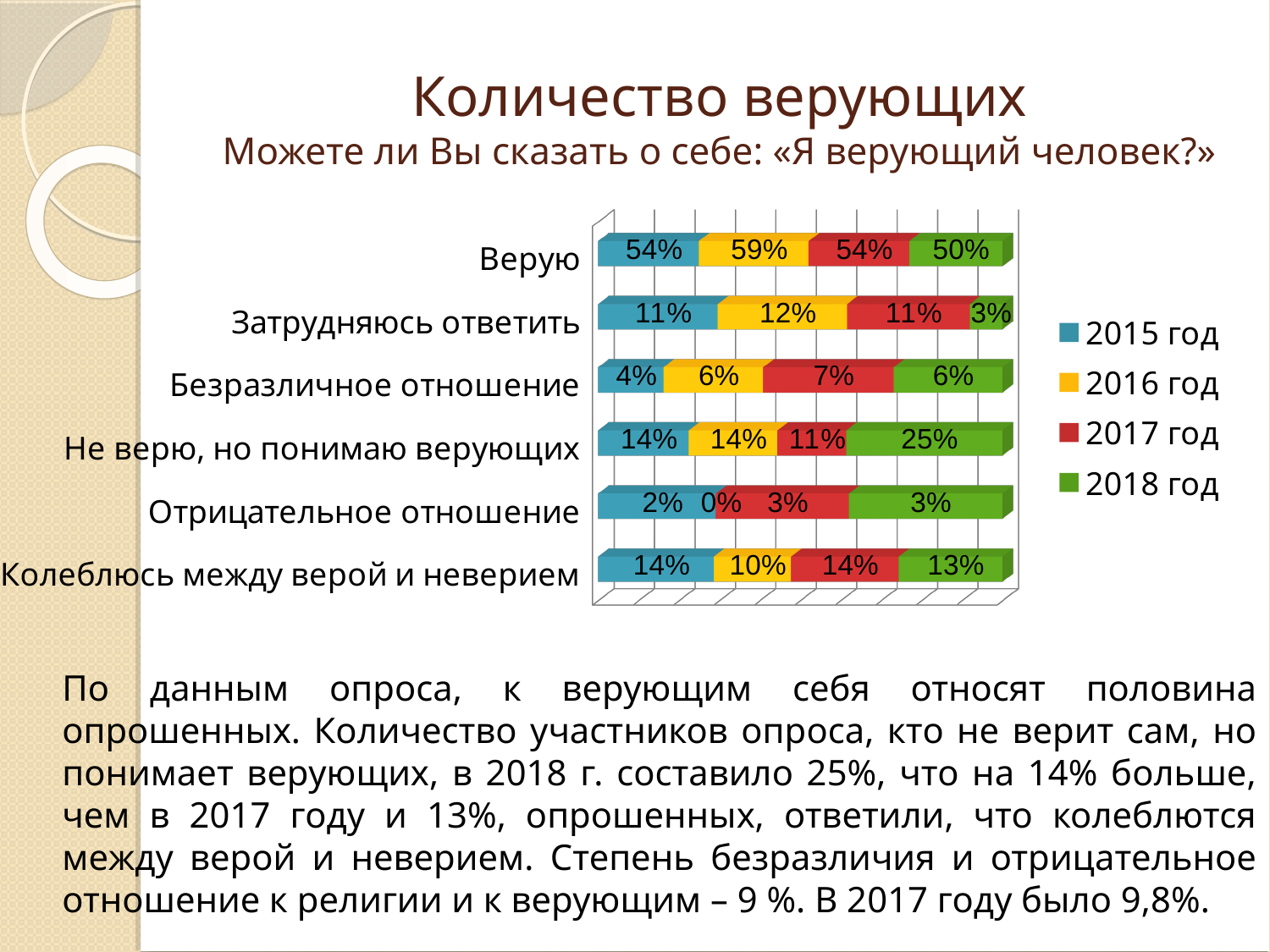
Which is larger for «Колеблюсь между верой и неверием»: the 2015 год value or the 2016 год value? 2015 год Which year has the highest value for «Верую»? 2016 год Which series is shown in green in the legend? 2018 год What is the value for «Отрицательное отношение» in 2016 год? 0% How many categories are shown on the chart? 6 What is the value for «Затрудняюсь ответить» in 2018 год? 3% What is the value for «Не верю, но понимаю верующих» in 2018 год? 25% What kind of chart is shown on the slide? bar chart What is the value for «Верую» in 2016 год? 59% How many series does the legend list? 4 What is the difference between the 2018 год and 2017 год values for «Не верю, но понимаю верующих»? 14% Which year has the lowest value for «Безразличное отношение»? 2015 год